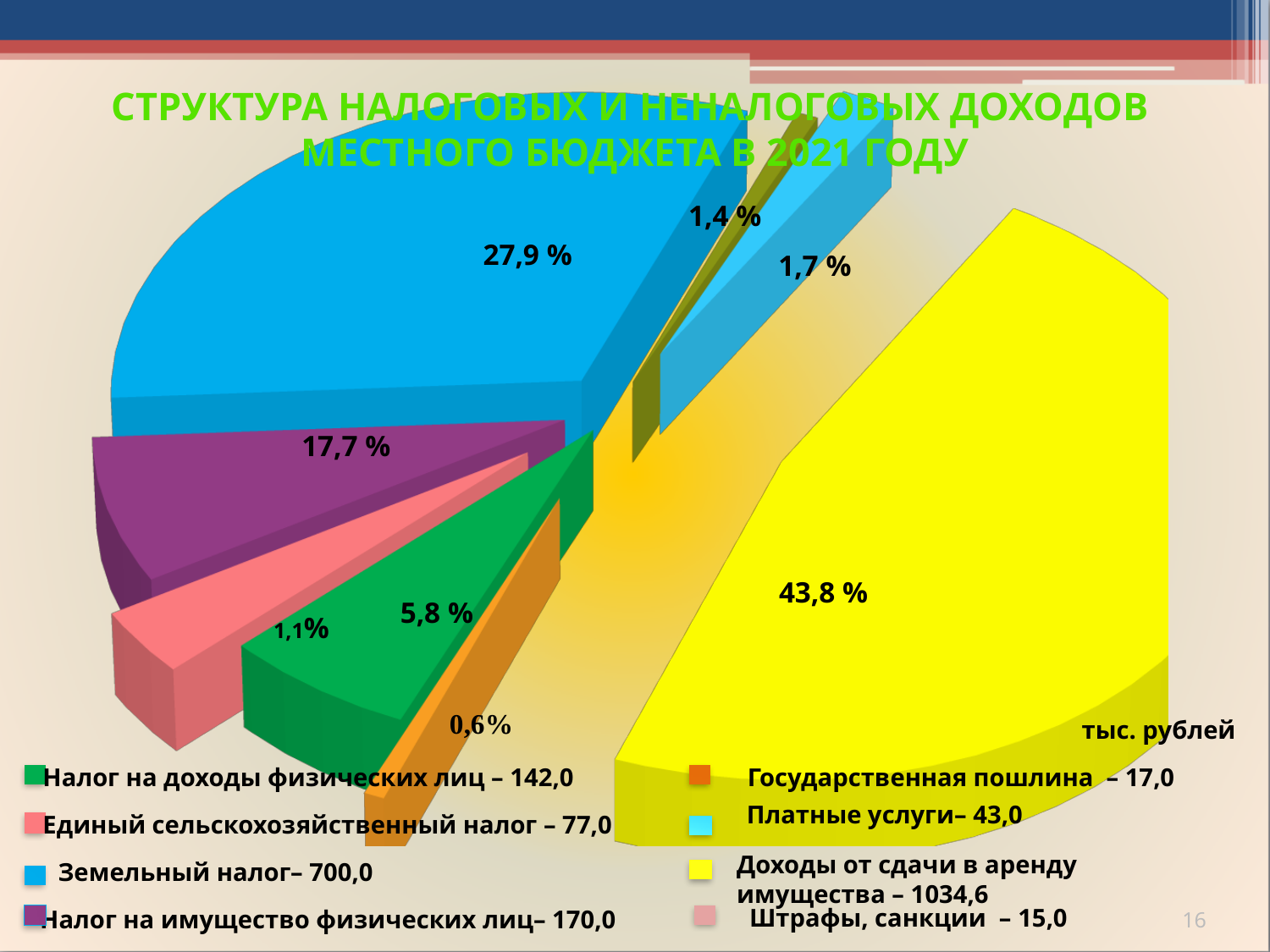
What percentage is shown on the blue slice (Земельный налог)? 27,9 % What share of the pie does the largest slice (Доходы от сдачи в аренду имущества, yellow) have? 43,8 % What percentage is shown on the green slice (Налог на доходы физических лиц)? 5,8 % What kind of chart is shown on the slide? pie chart What value does the legend give for Доходы от сдачи в аренду имущества? 1034,6 Which category has the largest share of the pie? Доходы от сдачи в аренду имущества In what unit are the legend values given? тыс. рублей How many categories does the legend list? 8 What value does the legend give for Государственная пошлина? 17,0 What value does the legend give for Земельный налог? 700,0 Which is larger according to the legend: Налог на доходы физических лиц or Налог на имущество физических лиц? Налог на имущество физических лиц